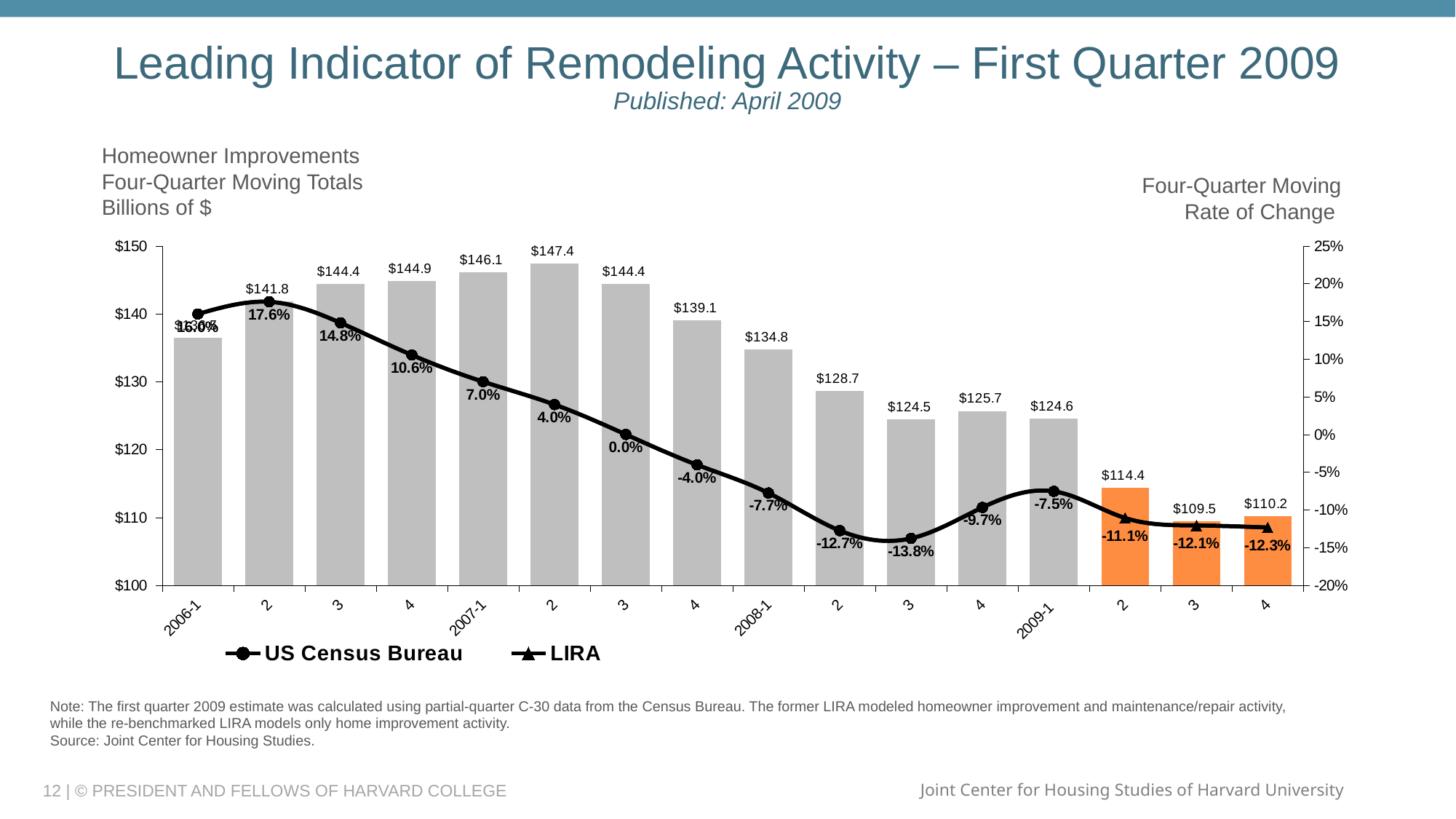
Which quarter has the highest four-quarter moving total? 2007-2 What is the difference between the four-quarter moving totals for 2007-2 and 2009-3? $37.9 What is the four-quarter moving total for 2009-3? $109.5 Which is larger, the four-quarter moving total for 2008-4 or for 2009-1? 2008-4 What are the two series named in the legend? US Census Bureau and LIRA How many series does the legend list? 2 Which quarter has the lowest four-quarter moving total? 2009-3 What is the four-quarter moving rate of change for 2006-2? 17.6% Do the four-quarter moving totals generally rise or fall from 2007-2 to 2009-3? fall What is the four-quarter moving total for 2007-2? $147.4 How many quarters are shown on the x axis? 16 What is the four-quarter moving rate of change for 2008-3? -13.8%